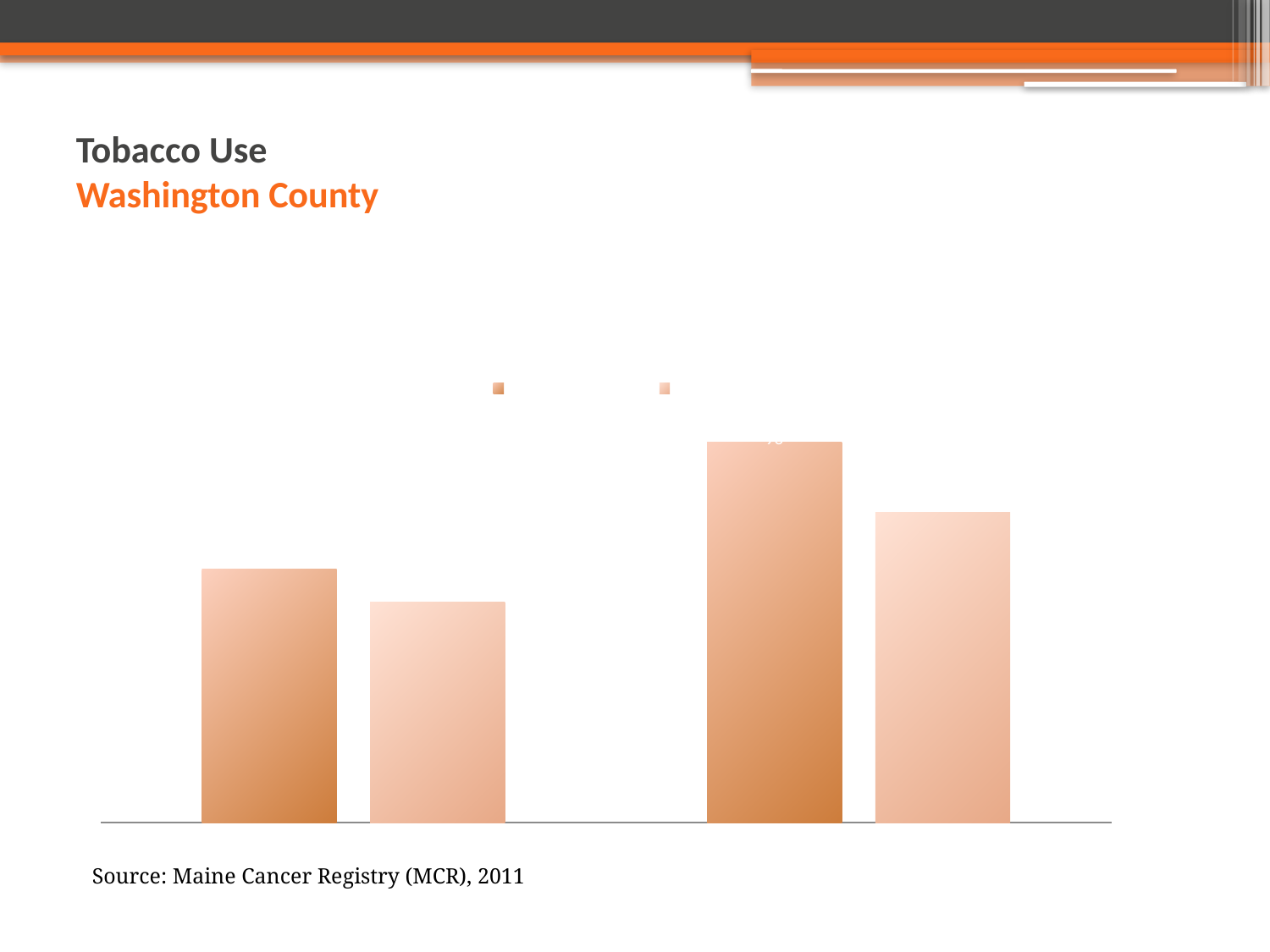
Which bar is the tallest in the chart? the third bar from the left What kind of chart is shown on the slide? bar chart What is the title shown above the chart on the slide? Tobacco Use Washington County How many bars are plotted in the chart? 4 How many groups of bars does the chart show? 2 How many series does the chart's legend list? 2 Is the right group of bars taller or shorter than the left group of bars? taller In the left group of bars, is the darker orange bar taller or shorter than the lighter bar? taller What source is cited below the chart? Maine Cancer Registry (MCR), 2011 Which bar is the shortest in the chart? the second bar from the left In the right group of bars, is the darker orange bar taller or shorter than the lighter bar? taller